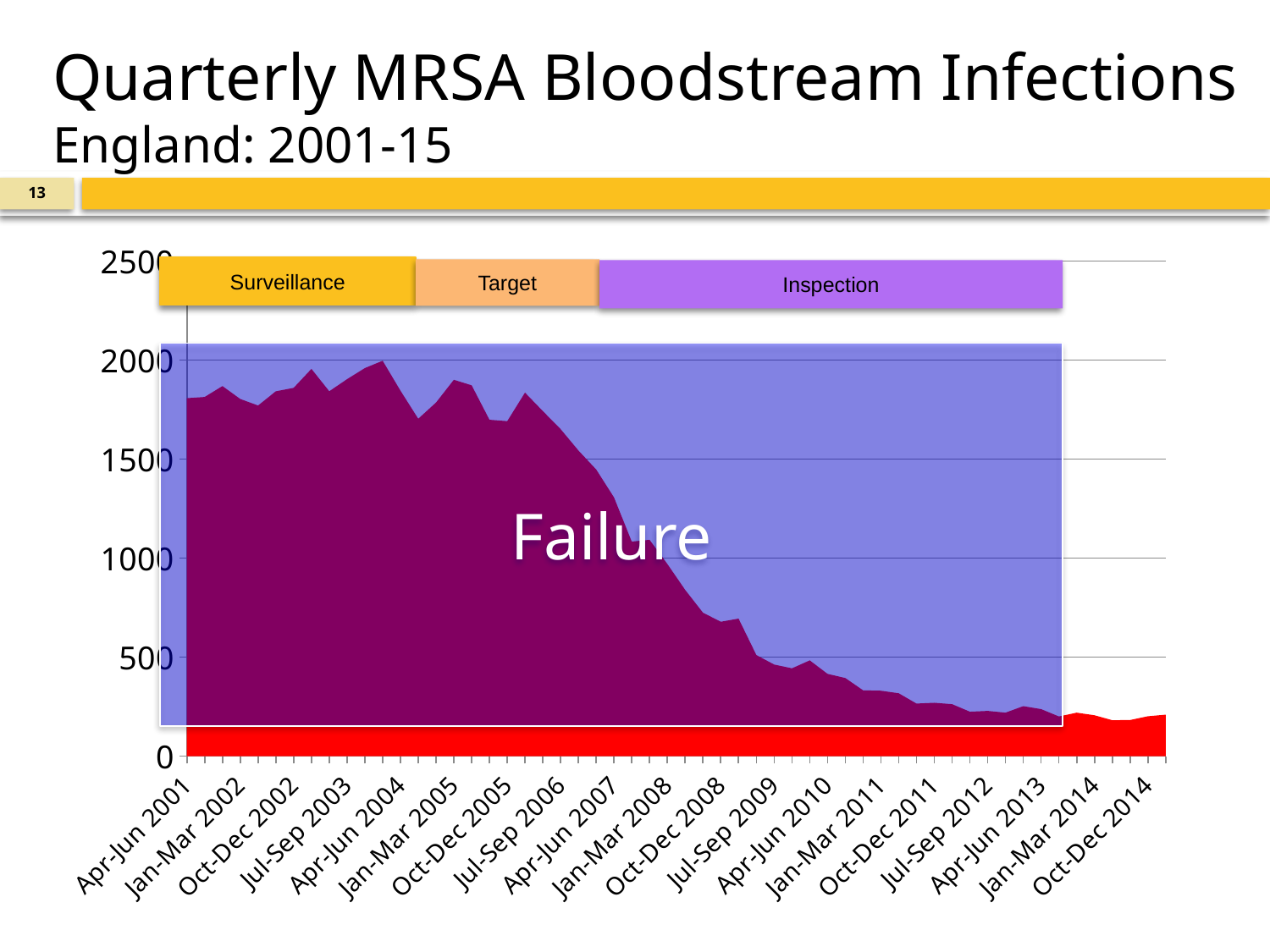
Do the quarterly MRSA bloodstream infection values generally rise or fall from 2001 to 2015? fall Is the value for Oct-Dec 2014 greater or less than 500? less Which quarter has the larger value, Jan-Mar 2005 or Jul-Sep 2009? Jan-Mar 2005 Is the value for Jul-Sep 2003 greater or less than 1000? greater What kind of chart is shown on the slide? area chart Is the value for Oct-Dec 2008 greater or less than 1000? less Which quarter has the larger value, Apr-Jun 2001 or Oct-Dec 2014? Apr-Jun 2001 What are the three phase labels shown in the boxes above the chart area? Surveillance, Target, Inspection What is the title of the chart on the slide? Quarterly MRSA Bloodstream Infections England: 2001-15